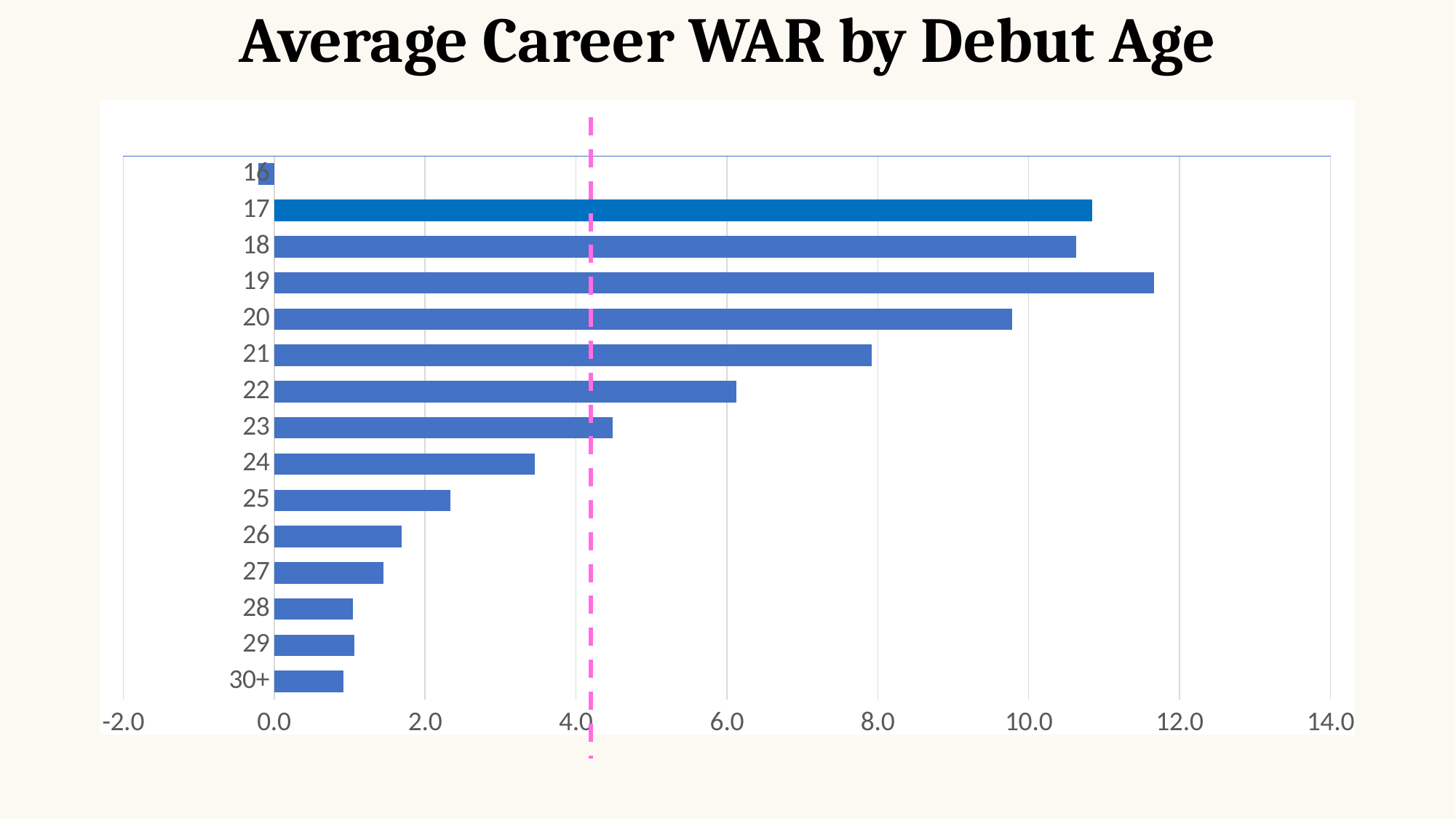
Is the value for debut age 24 greater or less than 4.0? less How many debut age categories are plotted in the chart? 15 What type of chart is shown on the slide? Bar chart Which debut age has the lowest average career WAR? 16 From debut age 19 down to 30+, do the bar values generally rise or fall? fall Is the value for debut age 20 greater or less than 8.0? greater Which has a larger average career WAR, debut age 20 or debut age 21? 20 What is the title of the chart? Average Career WAR by Debut Age Is the value for debut age 27 greater or less than 2.0? less Which has a larger average career WAR, debut age 24 or debut age 25? 24 Which debut age has the highest average career WAR? 19